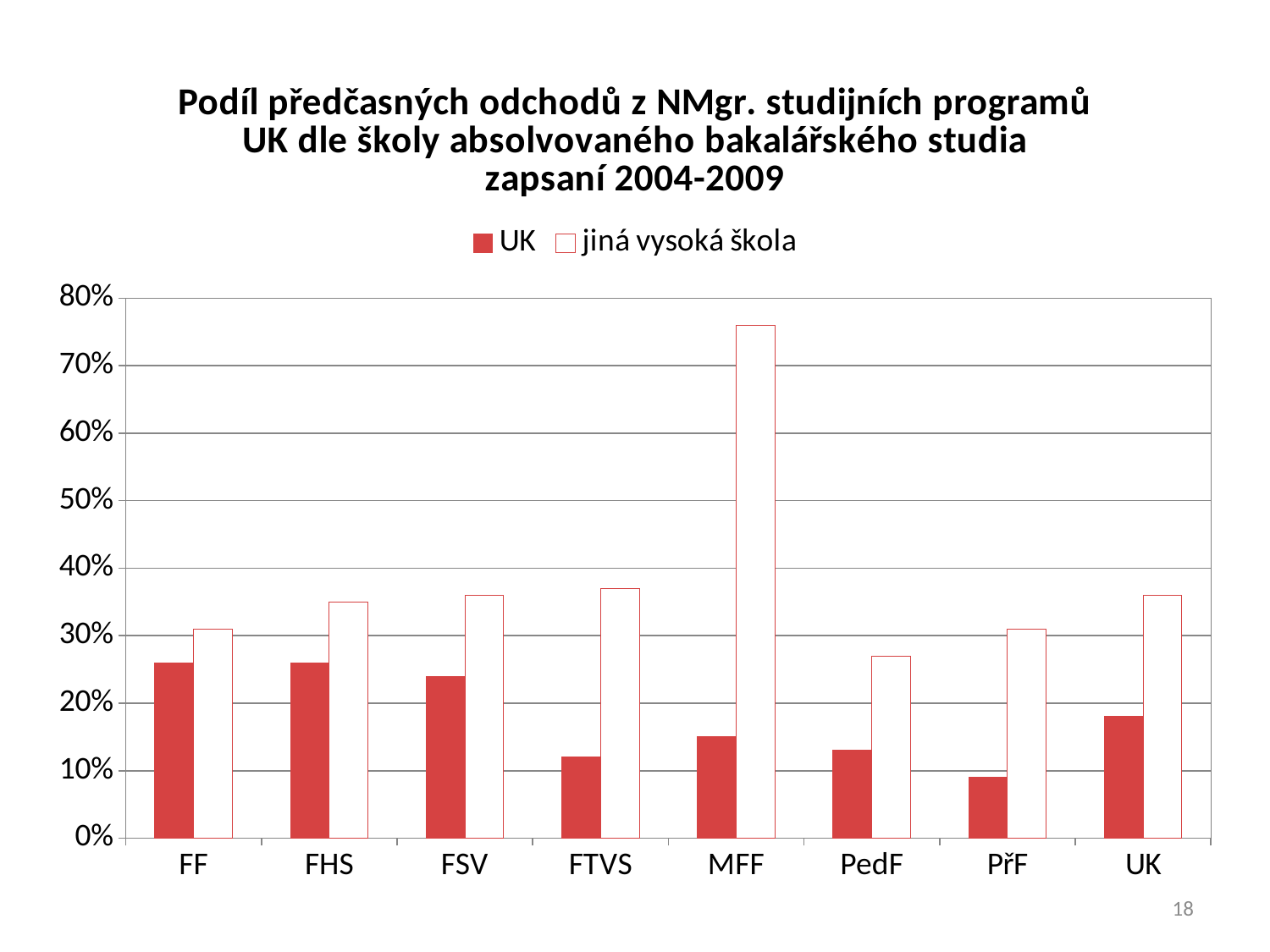
Is the 'jiná vysoká škola' value for FTVS greater or less than 30%? greater Which is larger: the 'jiná vysoká škola' value for MFF or for FF? MFF Is the 'jiná vysoká škola' value for MFF greater or less than 70%? greater Is the 'UK' value for PřF greater or less than 10%? less Which category has the highest value for the 'jiná vysoká škola' series? MFF For FTVS, which series has the larger value, 'UK' or 'jiná vysoká škola'? jiná vysoká škola How many categories are shown on the x axis? 8 What kind of chart is shown on the slide? bar chart How many series does the legend list? 2 Which category has the lowest value for the 'UK' series? PřF What are the two series named in the legend? UK and jiná vysoká škola